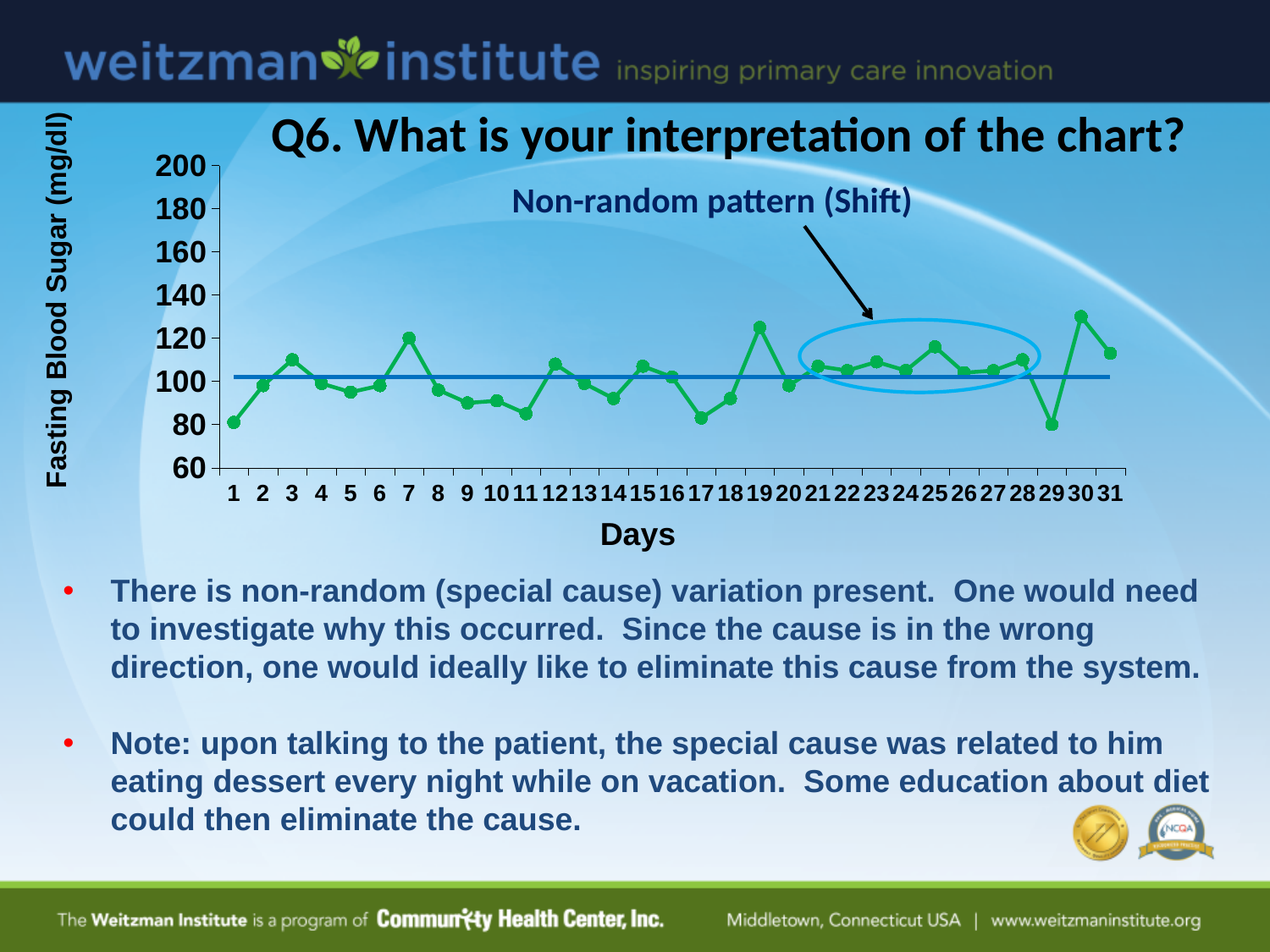
Is the value for day 29 greater or less than 100? less Is the value for day 25 greater or less than 100? greater What label is written in the annotation pointing to the circled points on the chart? Non-random pattern (Shift) Is the value for day 11 greater or less than 100? less How many days (data points) are plotted on the chart? 31 What is the title of the chart's vertical axis? Fasting Blood Sugar (mg/dl) What kind of chart is shown on the slide? line chart